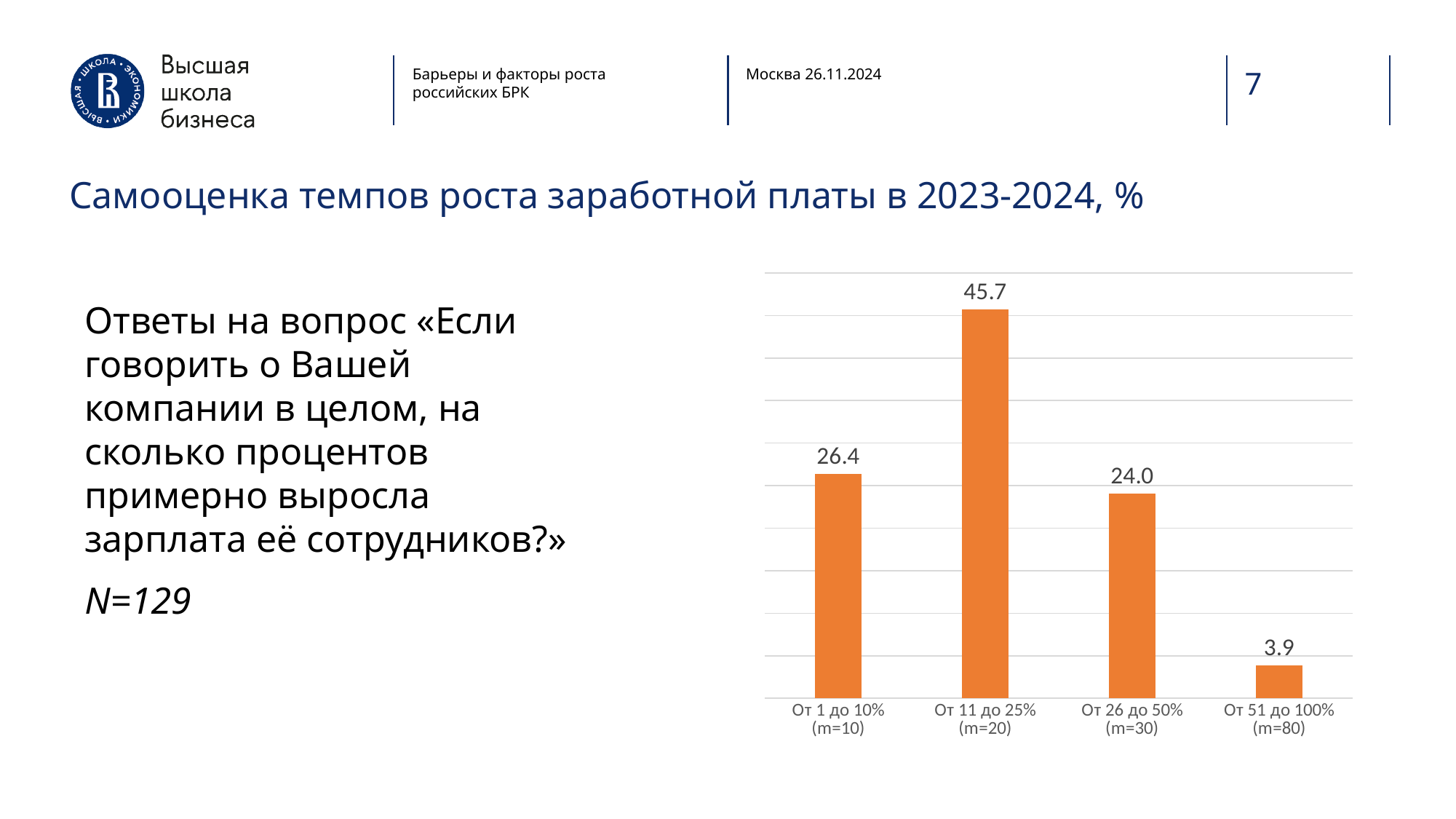
What is the value for the category 'От 26 до 50% (m=30)'? 24.0 What is the value for the category 'От 11 до 25% (m=20)'? 45.7 What kind of chart is shown on the slide? Bar chart What is the value for the category 'От 1 до 10% (m=10)'? 26.4 What is the difference between the values for 'От 26 до 50% (m=30)' and 'От 51 до 100% (m=80)'? 20.1 What is the value for the category 'От 51 до 100% (m=80)'? 3.9 Which category has the lowest value? От 51 до 100% (m=80) Which is larger: the value for 'От 1 до 10% (m=10)' or for 'От 26 до 50% (m=30)'? От 1 до 10% (m=10) What is the sample size (N) stated on the slide for the chart? N=129 What is the difference between the values for 'От 11 до 25% (m=20)' and 'От 1 до 10% (m=10)'? 19.3 Which category has the highest value? От 11 до 25% (m=20) How many categories are shown in the chart? 4